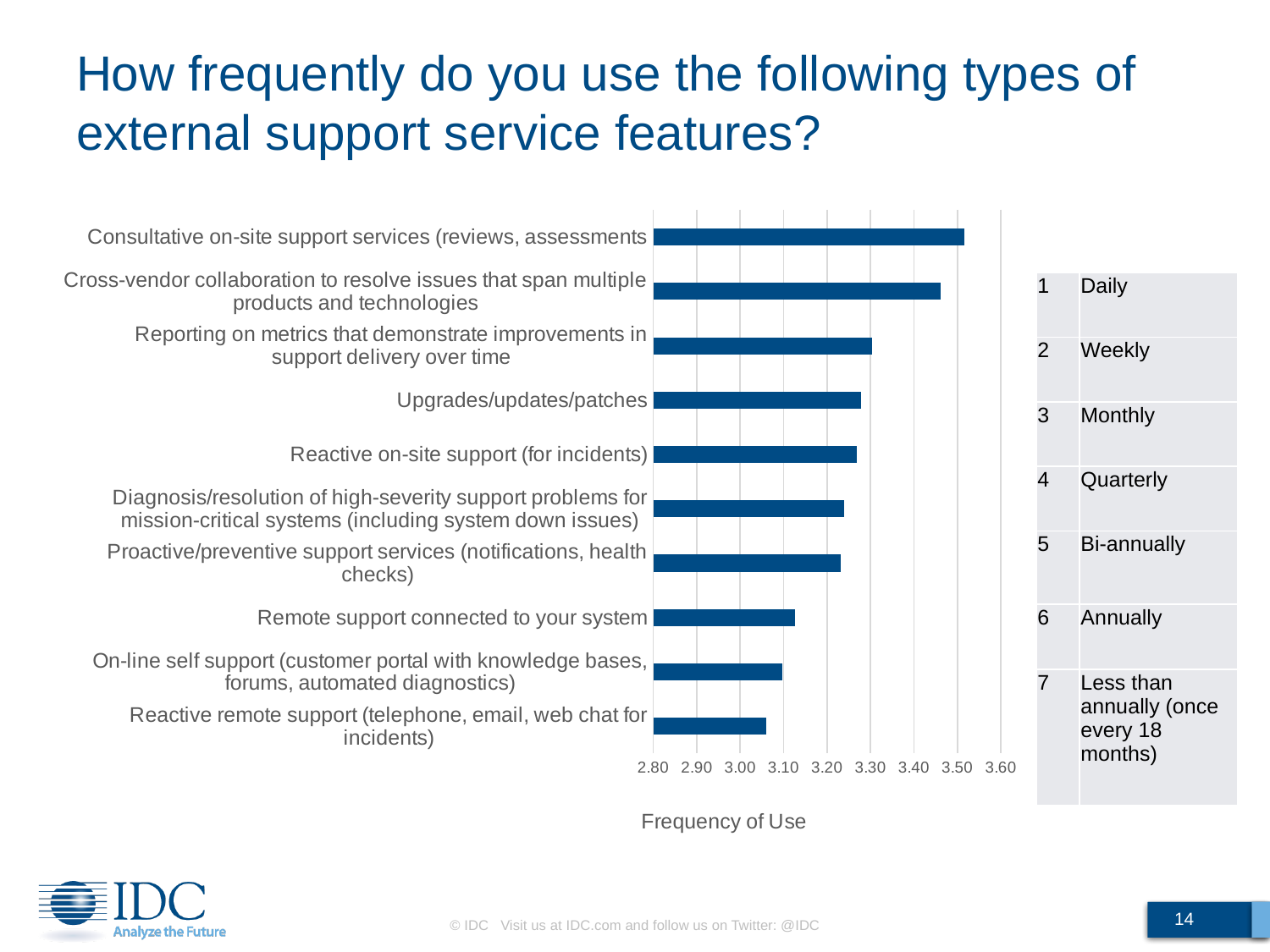
Is the value for On-line self support (customer portal with knowledge bases, forums, automated diagnostics) greater or less than 3.20? less Is the value for Cross-vendor collaboration to resolve issues that span multiple products and technologies greater or less than 3.40? greater What is the title of the horizontal axis of the chart? Frequency of Use What kind of chart is shown on the slide? Bar chart Which has a higher frequency of use: Reporting on metrics that demonstrate improvements in support delivery over time or Proactive/preventive support services (notifications, health checks)? Reporting on metrics that demonstrate improvements in support delivery over time Is the value for Reactive remote support (telephone, email, web chat for incidents) greater or less than 3.10? less Which has a higher frequency of use: Cross-vendor collaboration to resolve issues that span multiple products and technologies or Remote support connected to your system? Cross-vendor collaboration to resolve issues that span multiple products and technologies Which support service feature has the lowest frequency of use in the chart? Reactive remote support (telephone, email, web chat for incidents) How many support service feature categories are plotted in the chart? 10 Which support service feature has the highest frequency of use in the chart? Consultative on-site support services (reviews, assessments)